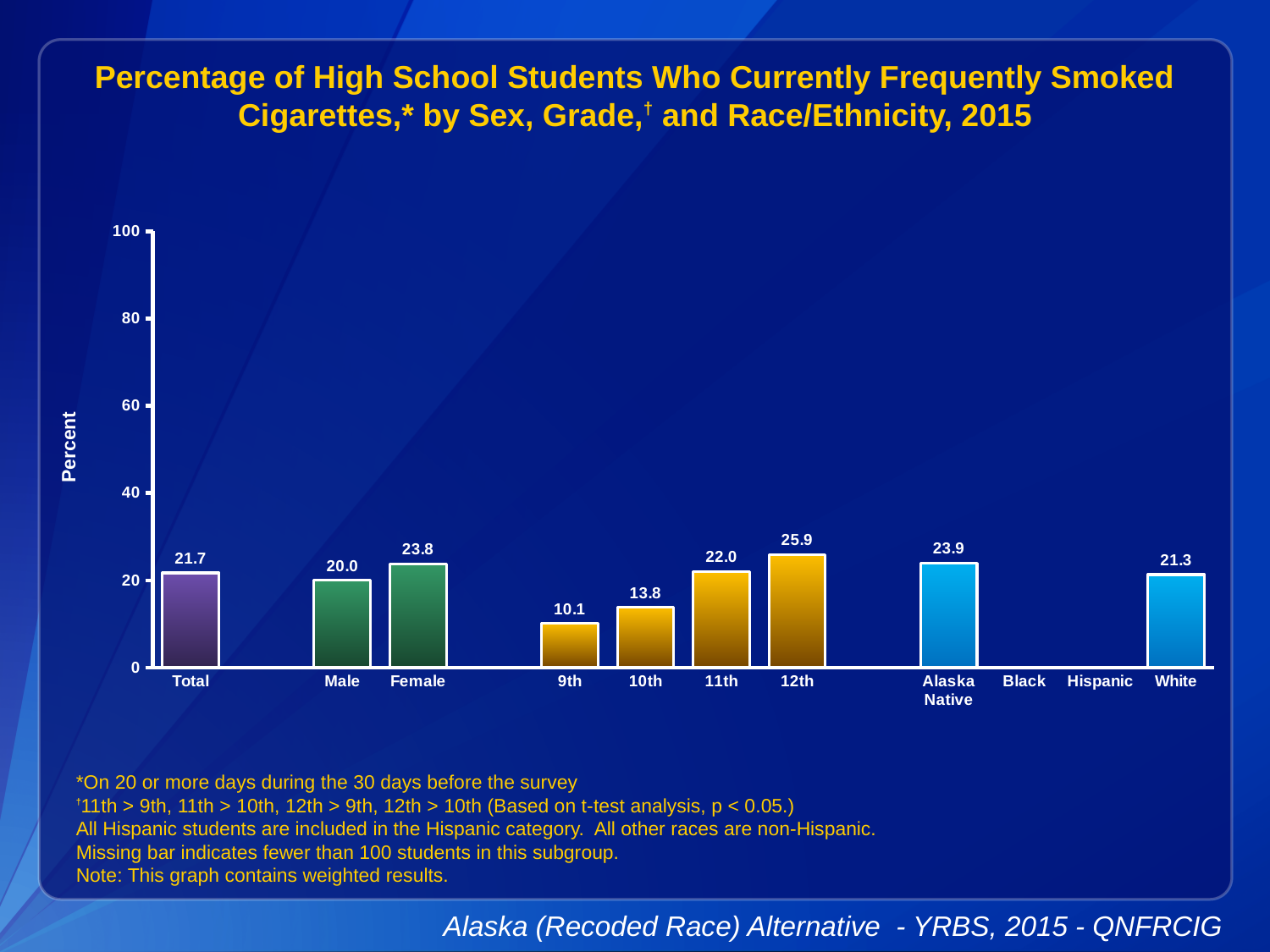
Which race/ethnicity categories have no bar shown? Black and Hispanic What kind of chart is shown on the slide? bar chart Which category has the lowest value among the bars shown? 9th Is the value for White students greater or less than 40? less What is the difference between the 12th grade and 9th grade values? 15.8 What is the value for Alaska Native students? 23.9 What percentage of 12th grade students currently frequently smoked cigarettes? 25.9 Which category has the highest value on the chart? 12th What is the difference between the Female and Male values? 3.8 What is the value for Total? 21.7 How many categories on the x axis have a bar plotted? 9 Which is larger, the value for 10th grade or the value for 11th grade? 11th